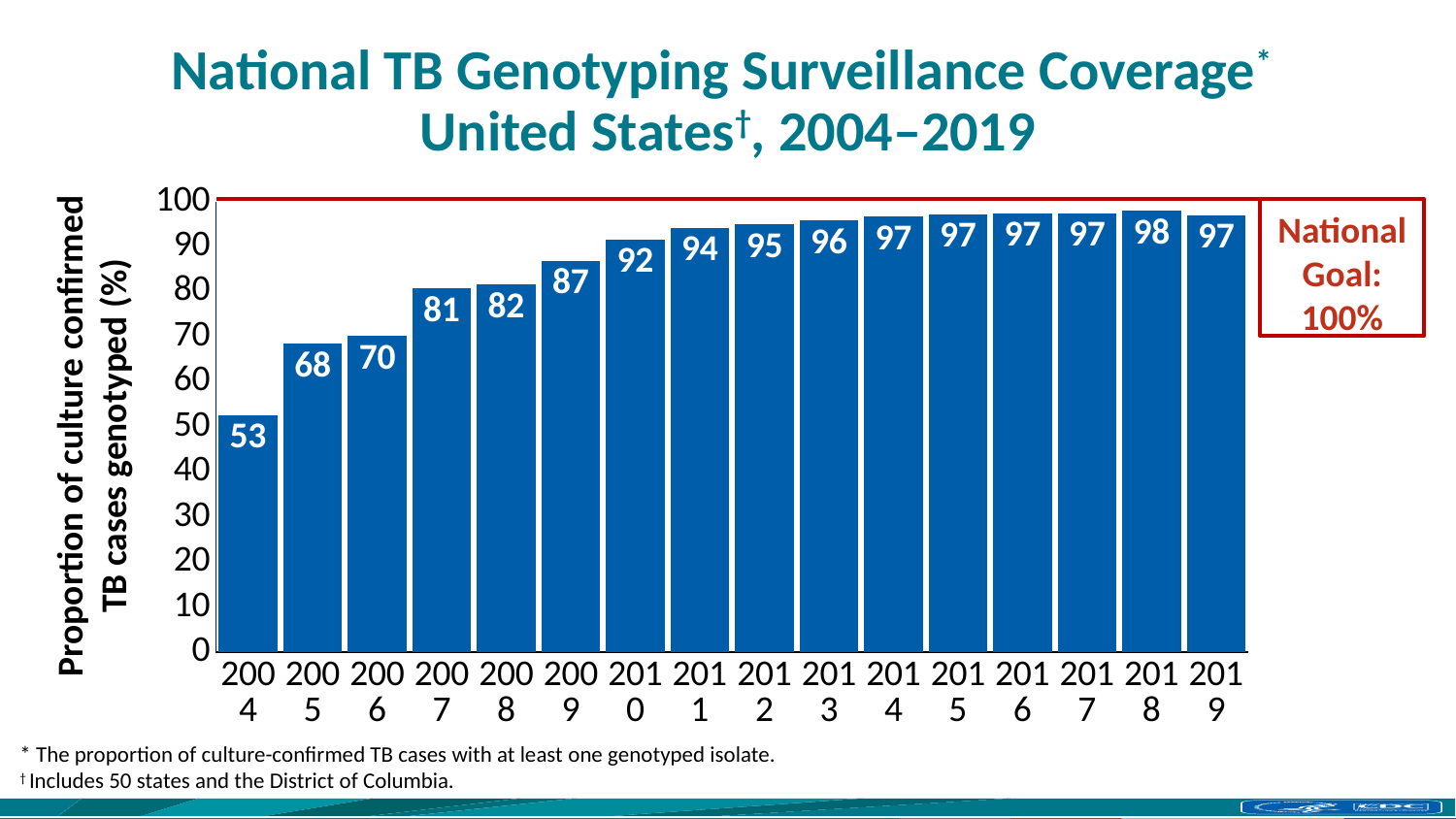
What was the proportion of culture-confirmed TB cases genotyped in 2004? 53 What is the difference between the values for 2019 and 2004? 44 Which year has the highest proportion of TB cases genotyped? 2018 How many years are shown on the x axis? 16 What is the difference between the values for 2010 and 2009? 5 Which year has a larger value, 2007 or 2011? 2011 What kind of chart is shown on the slide? Bar chart What is the national goal shown on the slide? 100% Do the values generally rise or fall from 2004 to 2019? Rise Which year has the lowest proportion of TB cases genotyped? 2004 What value is shown for 2018? 98 What value is shown for 2009? 87